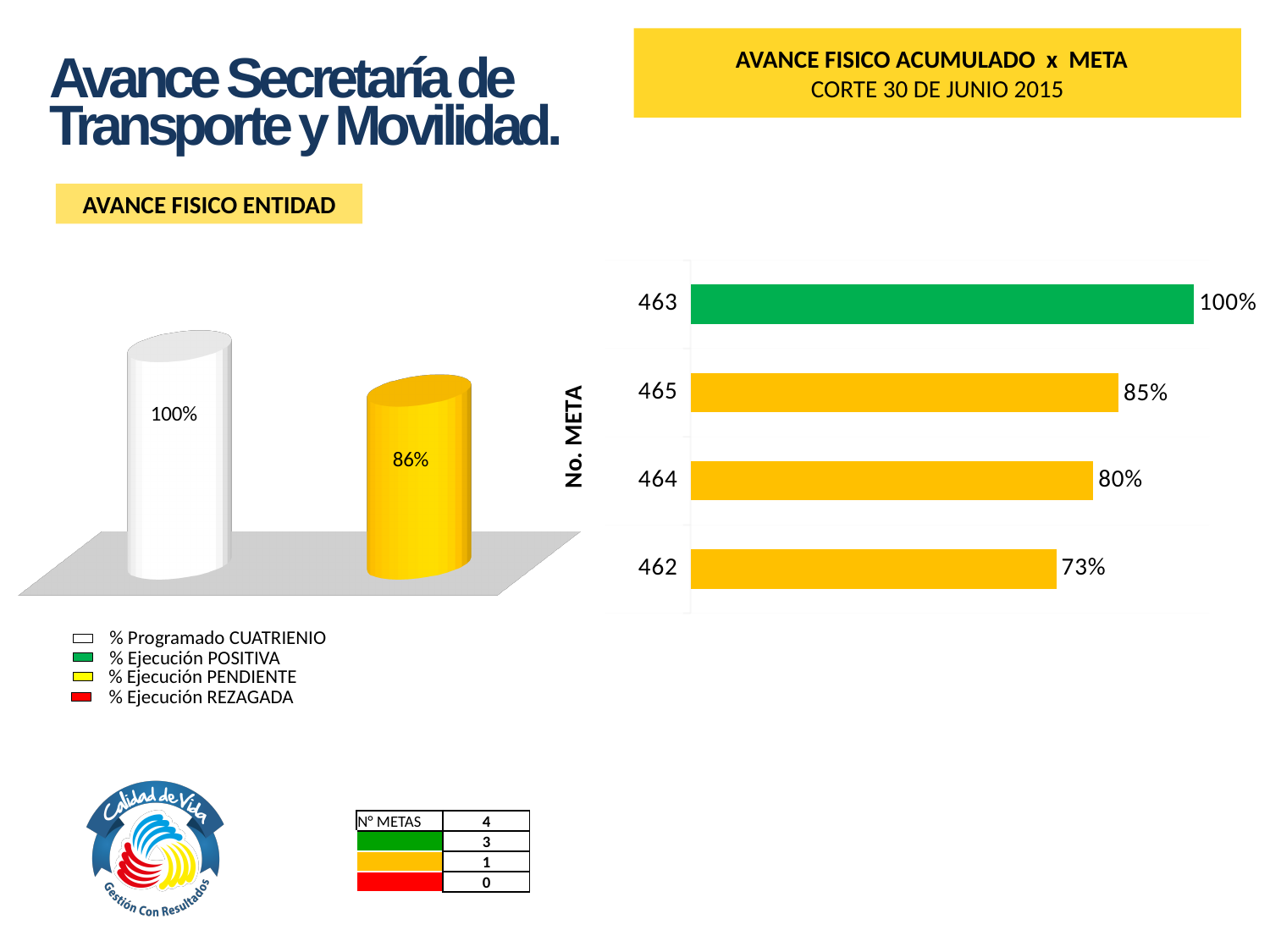
In the AVANCE FISICO ACUMULADO x META chart, what is the value for meta 463? 100% In the AVANCE FISICO ACUMULADO x META chart, what is the value for meta 462? 73% In the AVANCE FISICO ENTIDAD chart, what is the difference between the white bar and the yellow bar? 14% In the AVANCE FISICO ACUMULADO x META chart, what is the value for meta 464? 80% In the AVANCE FISICO ACUMULADO x META chart, which meta has the lowest value? 462 How many metas are shown in the AVANCE FISICO ACUMULADO x META chart? 4 What type of chart is the AVANCE FISICO ACUMULADO x META chart? Bar chart In the AVANCE FISICO ACUMULADO x META chart, which has a larger value, meta 465 or meta 464? 465 In the AVANCE FISICO ENTIDAD chart, what is the value of the yellow bar? 86% In the AVANCE FISICO ACUMULADO x META chart, which meta has the highest value? 463 How many entries does the legend of the AVANCE FISICO ENTIDAD chart list? 4 In the AVANCE FISICO ACUMULADO x META chart, what is the difference between the values for meta 465 and meta 462? 12%